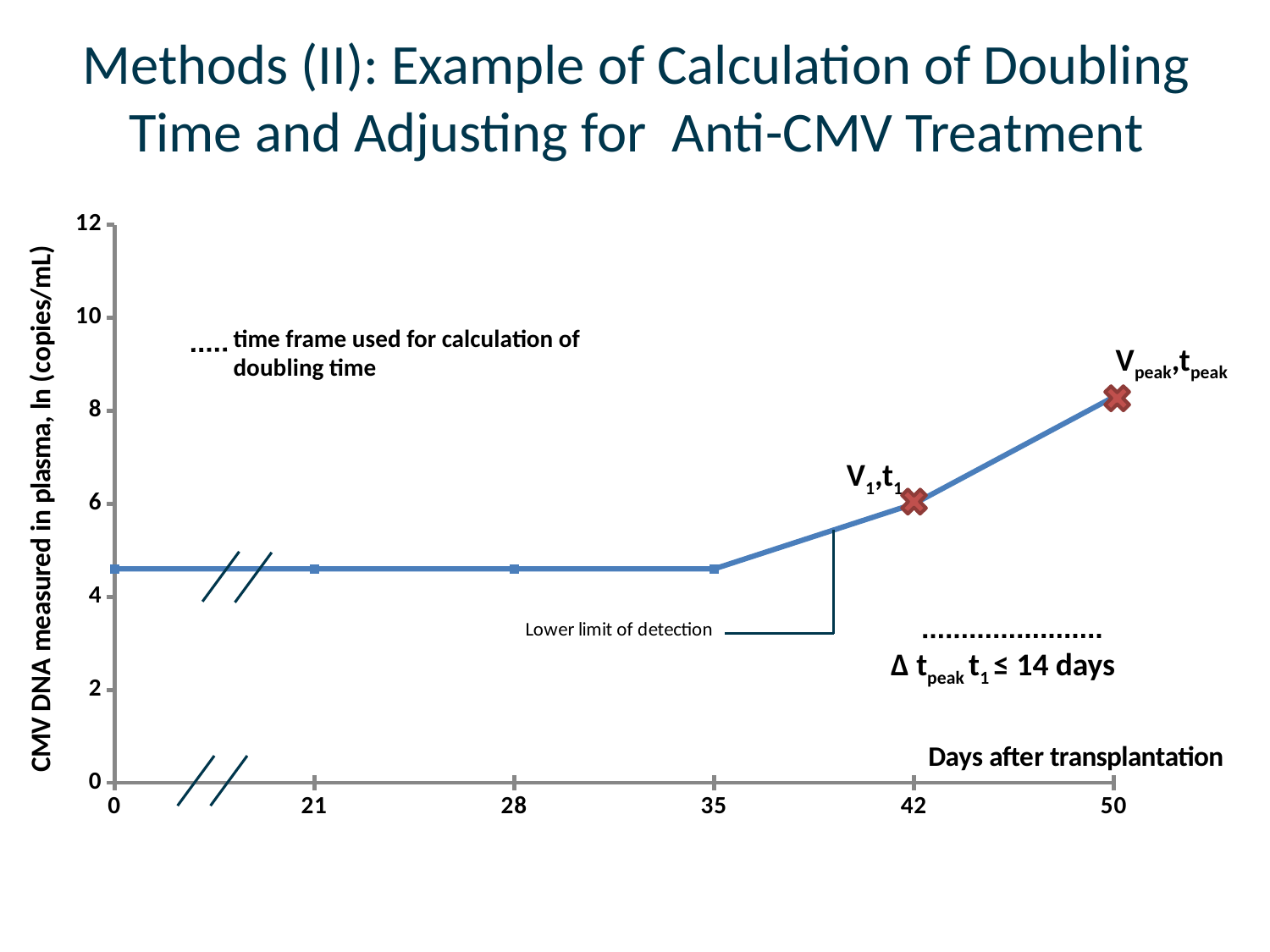
What is the title of the y axis? CMV DNA measured in plasma, ln (copies/mL) Which day after transplantation has the highest CMV DNA value on the chart? 50 How many tick labels are shown on the x axis (Days after transplantation)? 6 What kind of chart is shown on the slide? line chart Is the CMV DNA value at day 42 greater or less than 4? greater What does the annotation pointing to the flat part of the line say? Lower limit of detection Is the CMV DNA value at day 21 greater or less than 6? less Between day 35 and day 50, does the CMV DNA value rise or fall? rise Which has the larger CMV DNA value, day 28 or day 42? day 42 Which has the larger CMV DNA value, day 42 or day 50? day 50 Is the CMV DNA value at day 50 greater or less than 6? greater